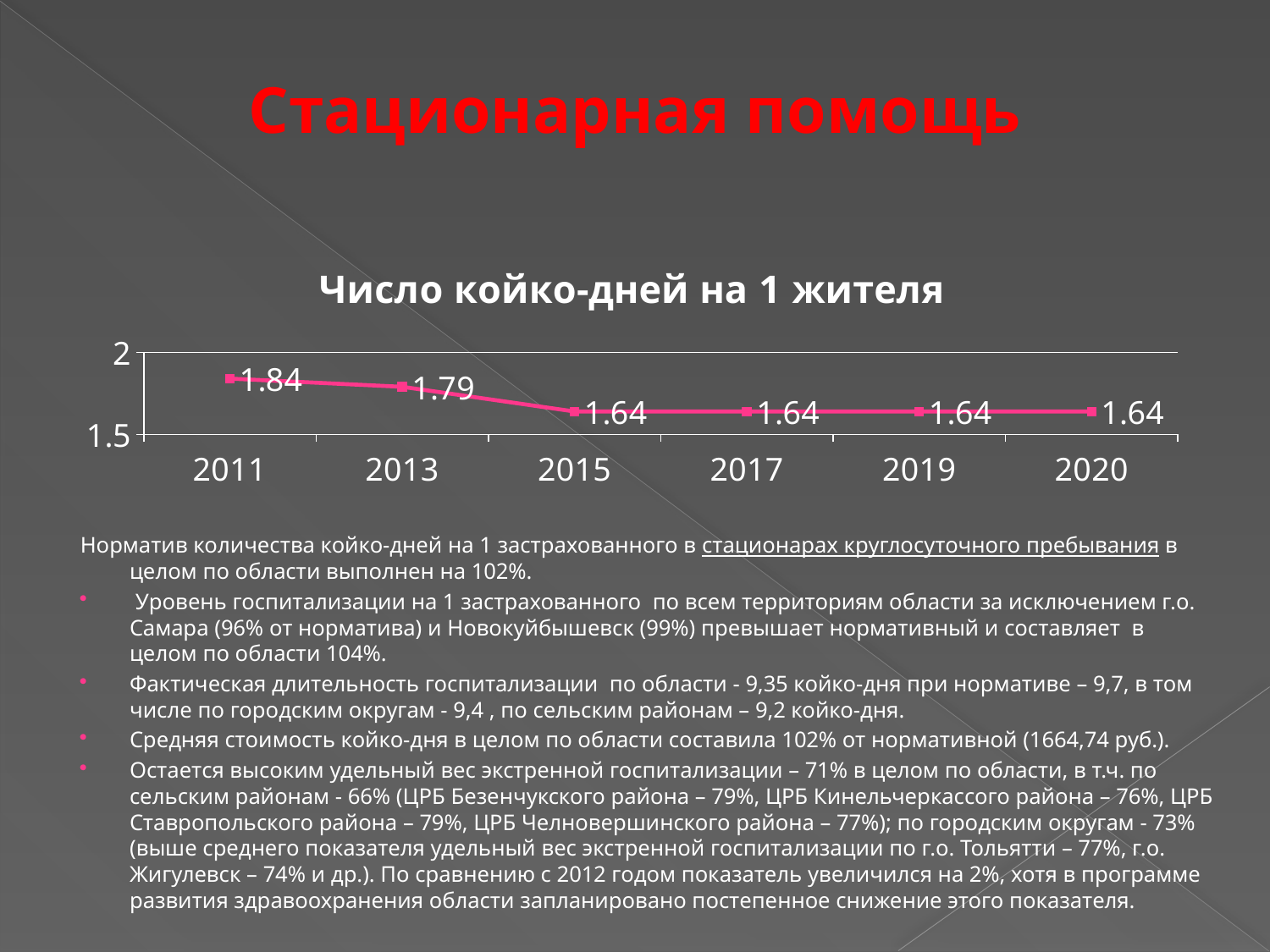
What is the difference between the values for 2011 and 2013? 0.05 What is the difference between the values for 2011 and 2020? 0.2 Do the values rise or fall from 2011 to 2015? fall What is the value for 2020? 1.64 What type of chart is shown on the slide? line chart How many data points are plotted on the chart? 6 What is the value for 2011? 1.84 Which year has the highest value? 2011 What is the value for 2013? 1.79 What is the title of the chart? Число койко-дней на 1 жителя Which is larger, the value for 2013 or the value for 2017? 2013 What is the value for 2015? 1.64